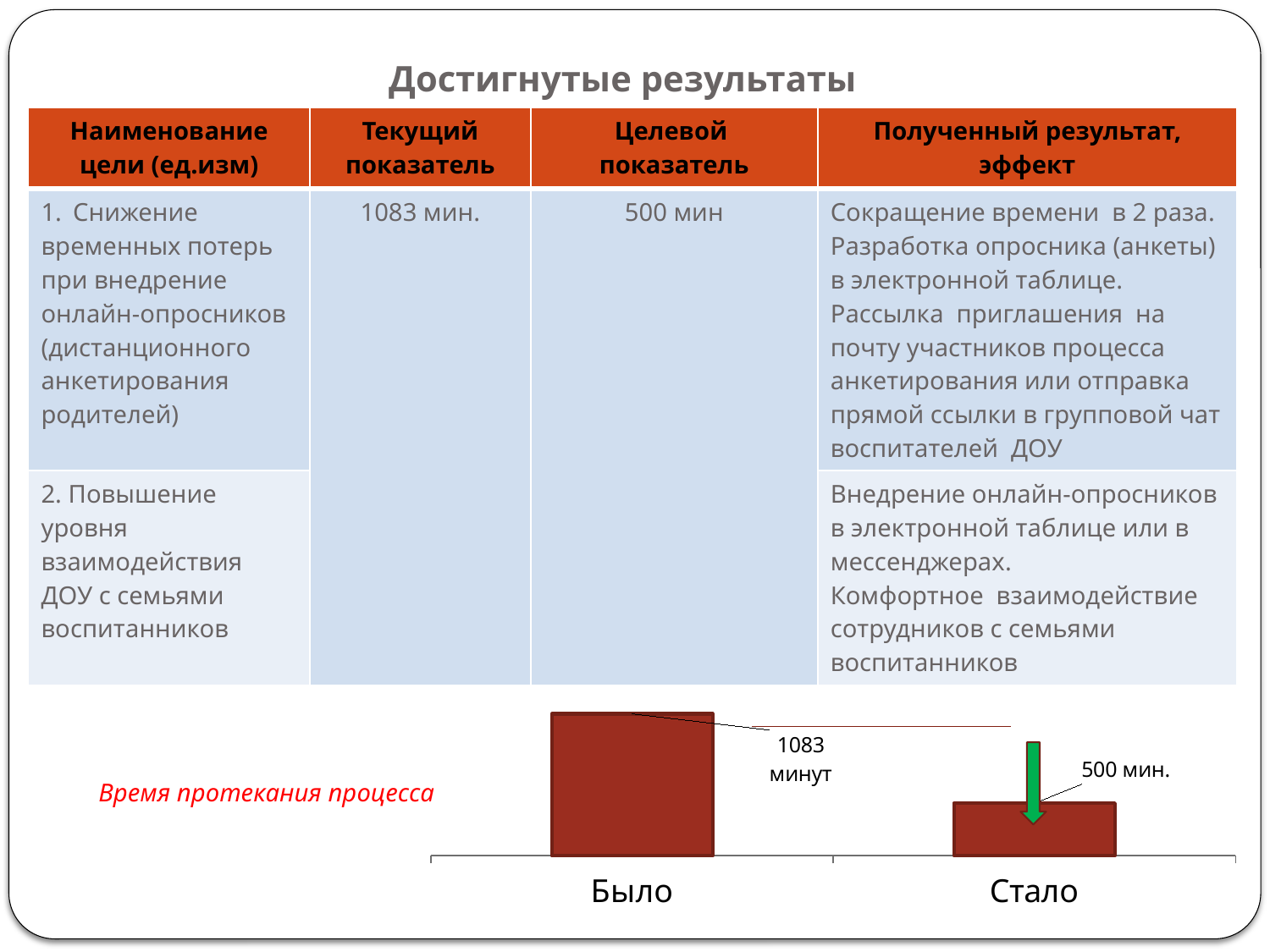
What value is shown for the "Стало" bar in the chart? 500 мин. What is the difference between the "Было" and "Стало" values in the chart? 583 Which is larger in the chart, the value for "Было" or the value for "Стало"? Было How many categories are shown on the x axis of the chart? 2 What is the red italic label to the left of the chart? Время протекания процесса What colour is the arrow pointing down onto the "Стало" bar? Green Which category in the chart has the lowest value? Стало Which category in the chart has the highest value? Было What kind of chart is shown at the bottom of the slide? Bar chart What value is shown for the "Было" bar in the chart? 1083 минут Do the values in the chart rise or fall from "Было" to "Стало"? Fall